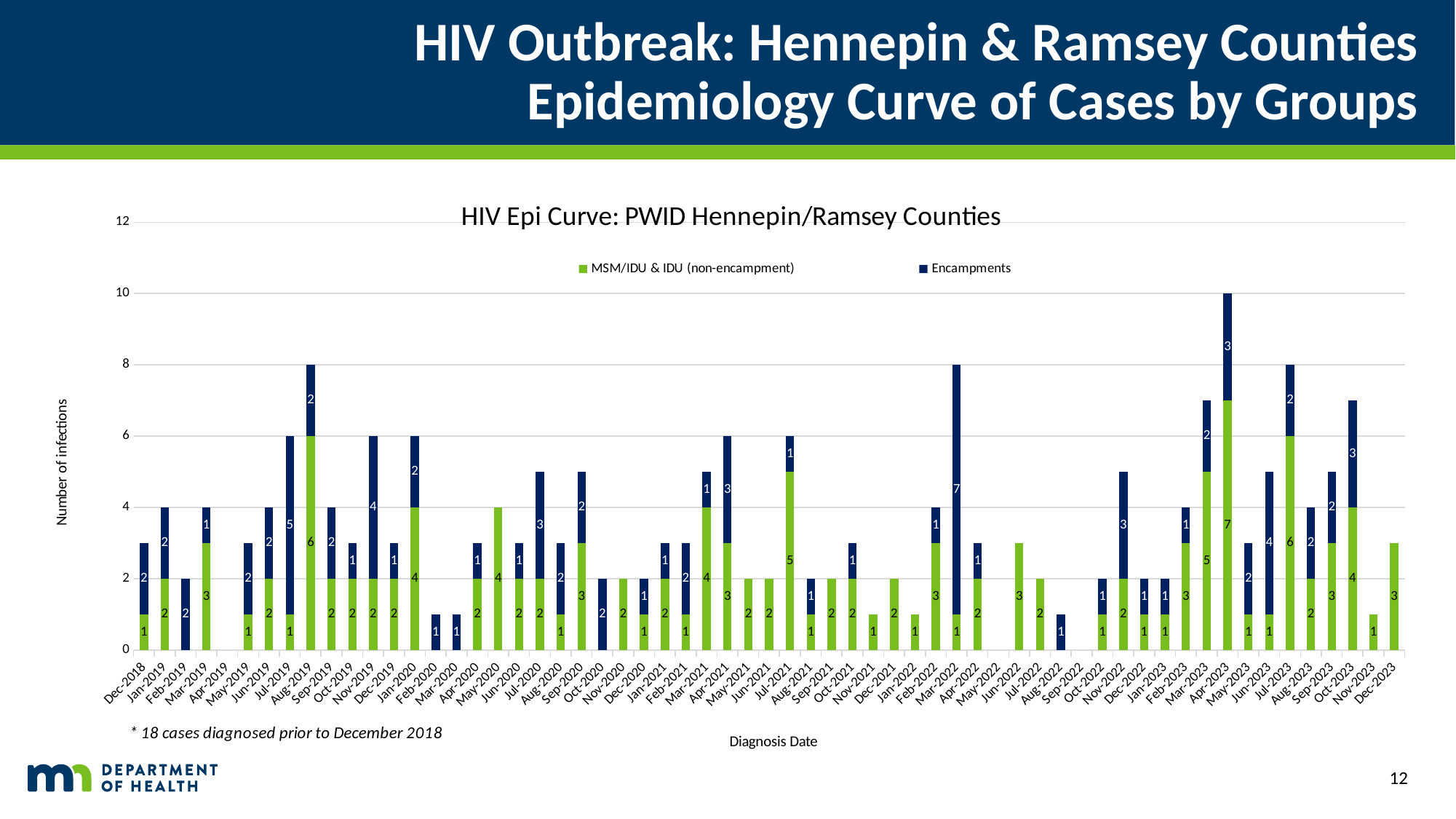
What is the Encampments value for Mar-2022? 7 How many series does the legend list? 2 What is the difference between the Encampments value for Mar-2022 and the Encampments value for Apr-2023? 4 Which is larger: the Encampments value for Nov-2019 or the Encampments value for Jul-2019? Jul-2019 What is the total of the stacked bar for Apr-2023? 10 Which month has the tallest stacked bar overall? Apr-2023 What is the title of the chart? HIV Epi Curve: PWID Hennepin/Ramsey Counties What kind of chart is shown on the slide? Stacked bar chart What is the MSM/IDU & IDU (non-encampment) value for Apr-2023? 7 What is the MSM/IDU & IDU (non-encampment) value for Aug-2019? 6 What is the total of the stacked bar for Jul-2023? 8 Is the total stacked bar for Mar-2023 greater or less than 6? greater